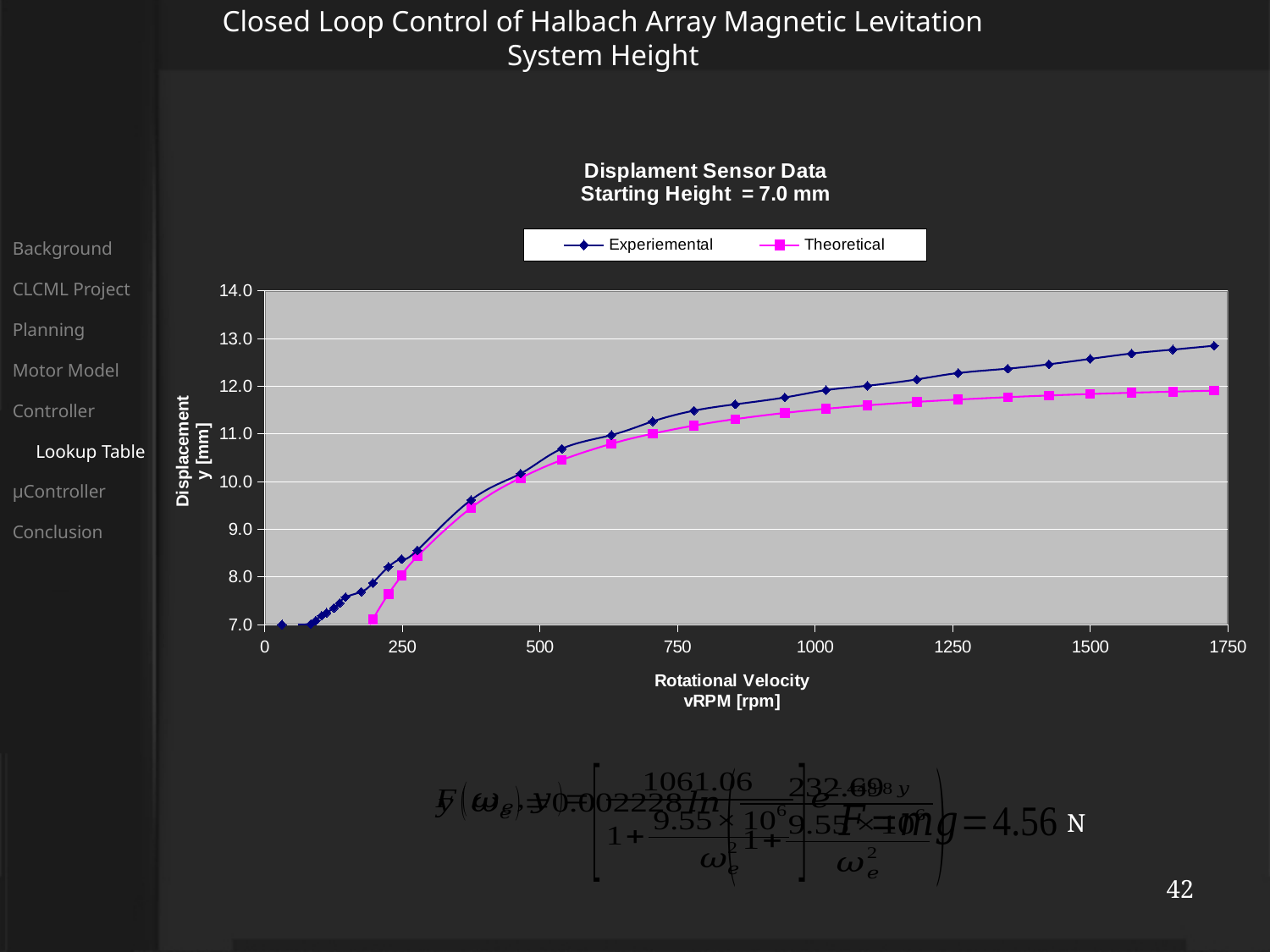
Is the Theoretical displacement at 1000 rpm greater or less than 11.0? greater Which series reaches the highest displacement on the chart? Experiemental Is the Experiemental displacement at 1750 rpm greater or less than 12.0? greater Do the Experiemental values rise or fall as rotational velocity increases? rise At 1500 rpm, which series shows the larger displacement, Experiemental or Theoretical? Experiemental Do the Theoretical values rise or fall as rotational velocity increases? rise At 1000 rpm, which series shows the larger displacement, Experiemental or Theoretical? Experiemental Is the Experiemental displacement at 500 rpm greater or less than 10.0? greater What is the title of the chart? Displament Sensor Data Starting Height = 7.0 mm How many series does the chart's legend list? 2 What kind of chart is shown on the slide? line chart What is the label of the vertical axis of the chart? Displacement y [mm]